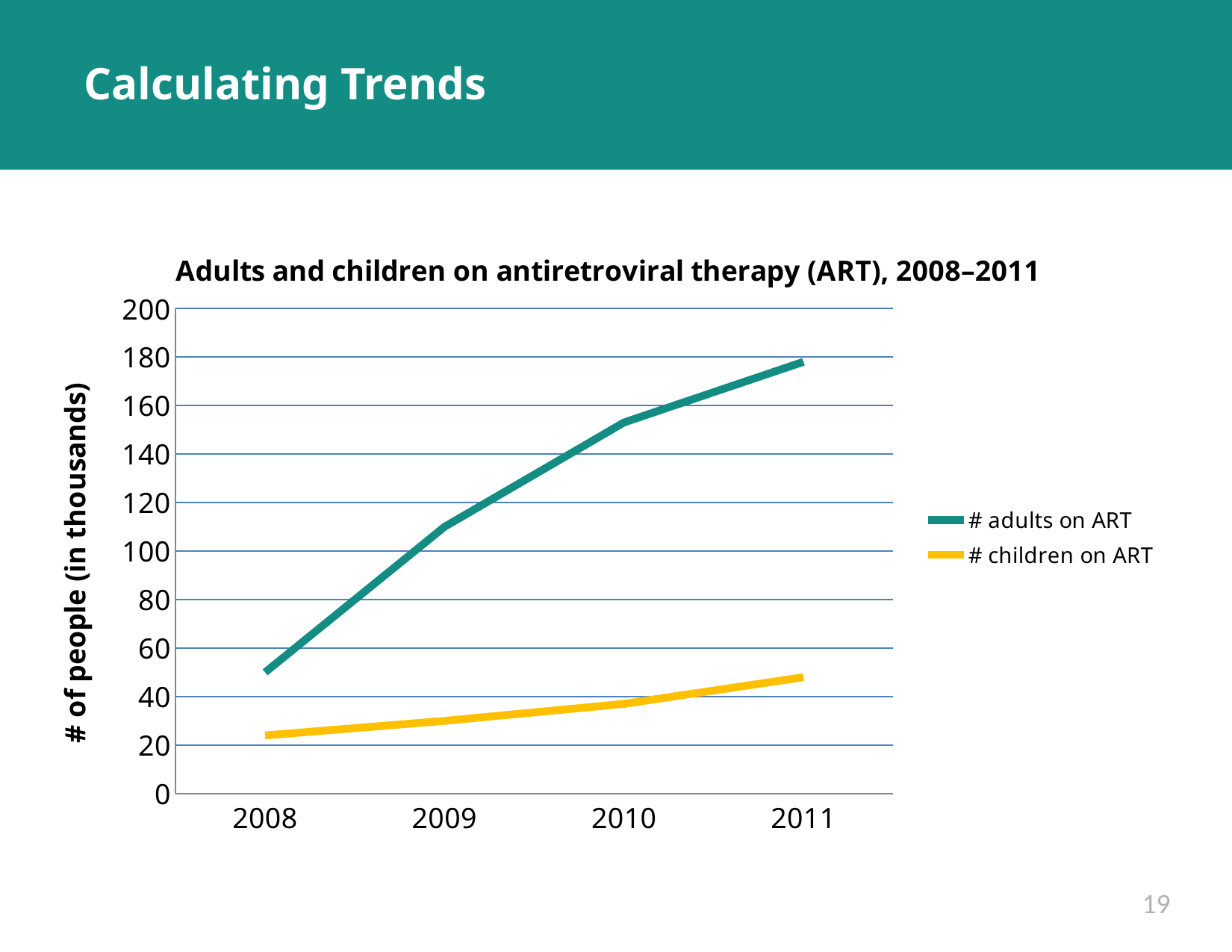
How many years are shown on the x axis? 4 What is the title of the chart? Adults and children on antiretroviral therapy (ART), 2008–2011 Is the value for # adults on ART in 2009 greater or less than 100? greater What kind of chart is shown on the slide? line chart Does the number of adults on ART rise or fall from 2008 to 2011? rise In which year is the number of children on ART lowest? 2008 Which series has the larger value in 2010, # adults on ART or # children on ART? # adults on ART In which year is the number of adults on ART highest? 2011 Does the number of children on ART rise or fall from 2008 to 2011? rise Is the value for # children on ART in 2011 greater or less than 60? less How many series does the legend list? 2 What is the label of the y axis? # of people (in thousands)